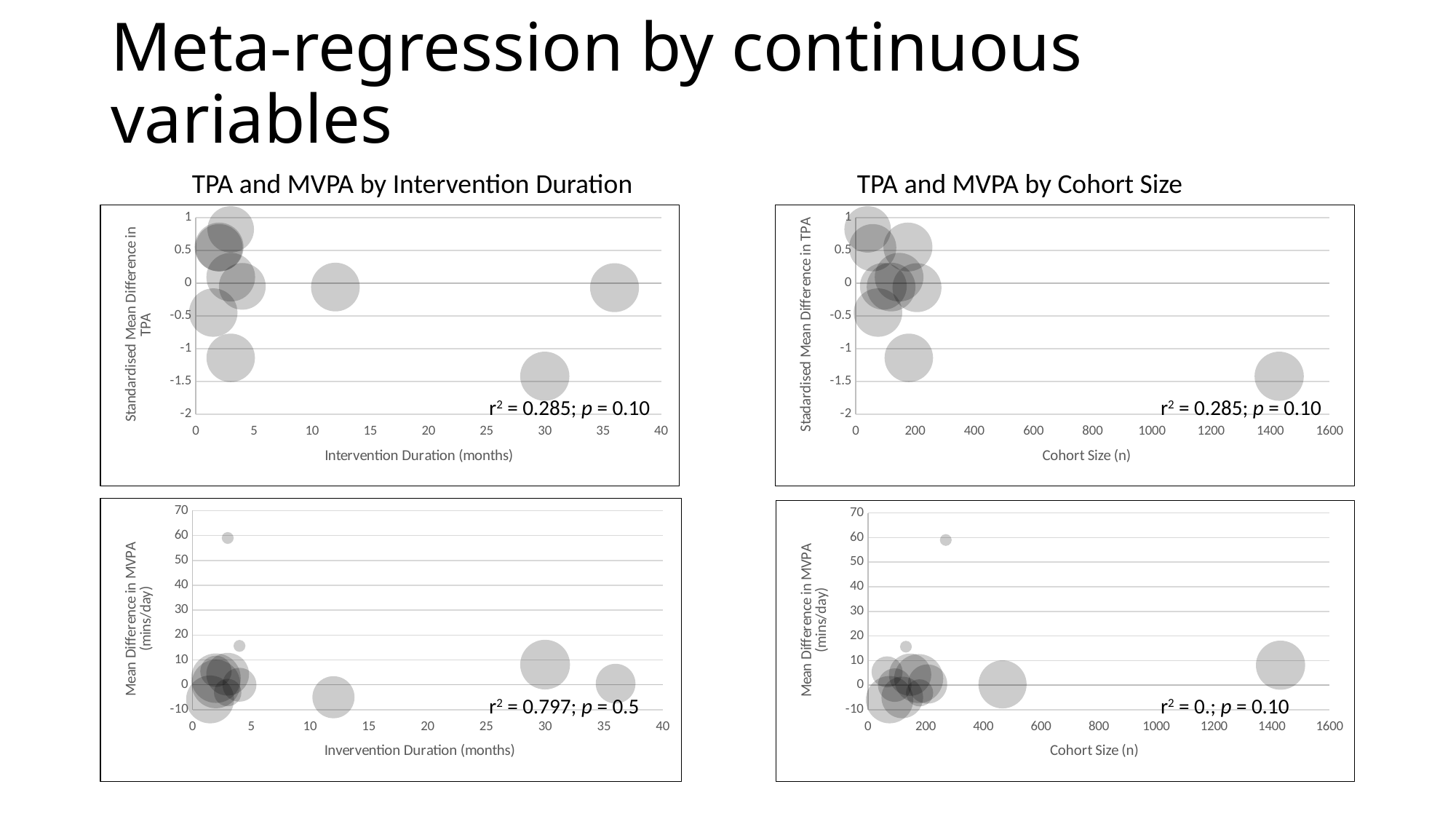
In the bottom-left chart (Mean Difference in MVPA vs Intervention Duration), is the value for the small bubble at about 3 months greater or less than 50? greater In the bottom-right chart (Mean Difference in MVPA vs Cohort Size), is the value for the small bubble at about 270 participants greater or less than 50? greater What is the x-axis title of the top-right chart under 'TPA and MVPA by Cohort Size'? Cohort Size (n) In the bottom-left chart (Mean Difference in MVPA vs Intervention Duration), is the value for the bubble at about 30 months greater or less than 0? greater In the top-left chart (Standardised Mean Difference in TPA vs Intervention Duration), is the value for the bubble at about 30 months greater or less than the value for the bubble at about 36 months? less What r² value is printed on the bottom-left chart (Mean Difference in MVPA vs Intervention Duration)? 0.797 What kind of chart is the top-left chart under 'TPA and MVPA by Intervention Duration'? bubble chart